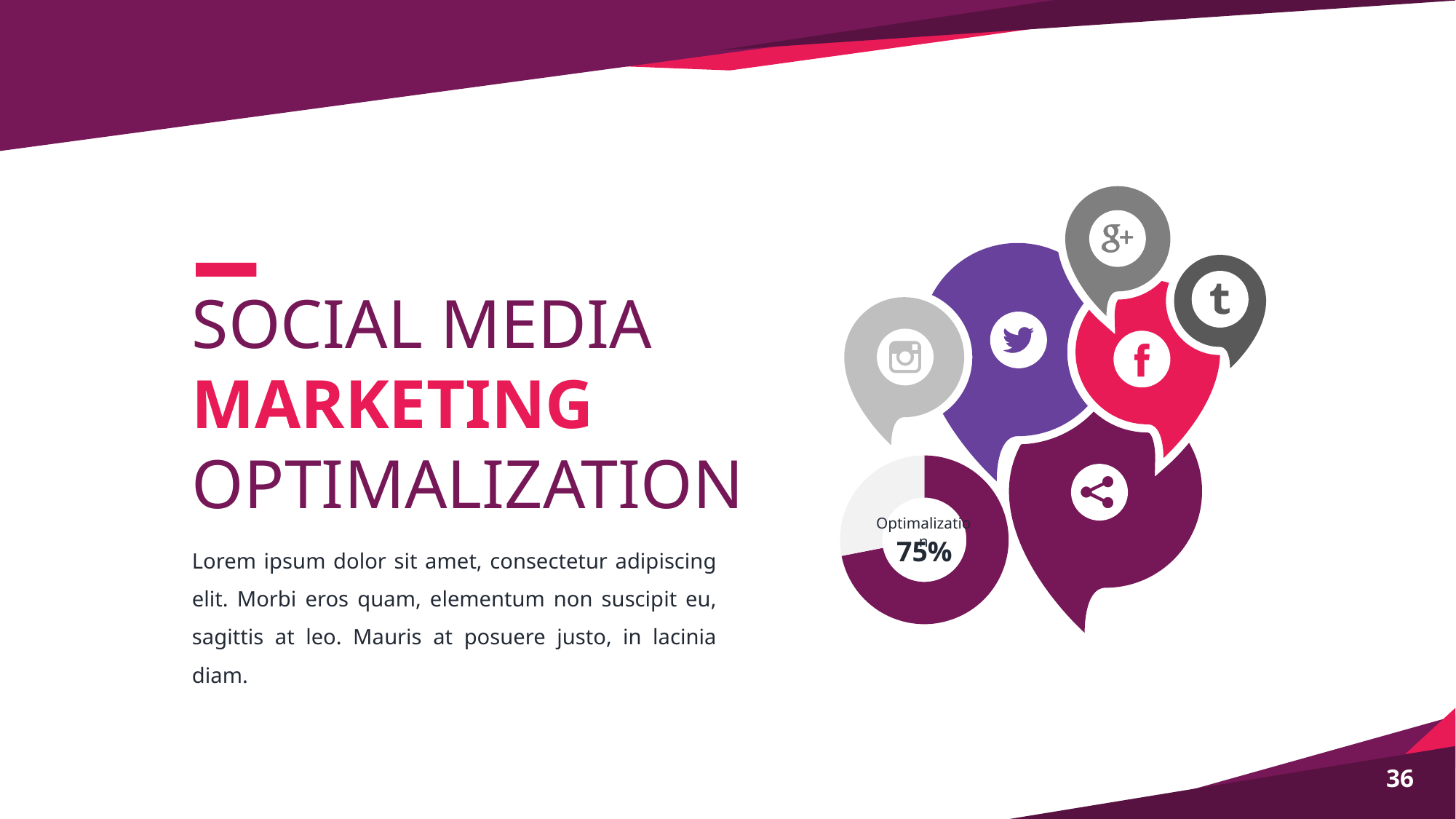
What percentage value is printed in the centre of the doughnut chart? 75% Which segment of the doughnut chart is larger, the dark purple one or the light grey one? the dark purple one What label is printed in the centre of the doughnut chart above the percentage? Optimalization What kind of chart is shown on the slide? doughnut chart What colour is the filled segment of the doughnut chart? dark purple Is the filled (dark purple) portion of the doughnut chart greater or less than 50%? greater How many segments does the doughnut chart have? 2